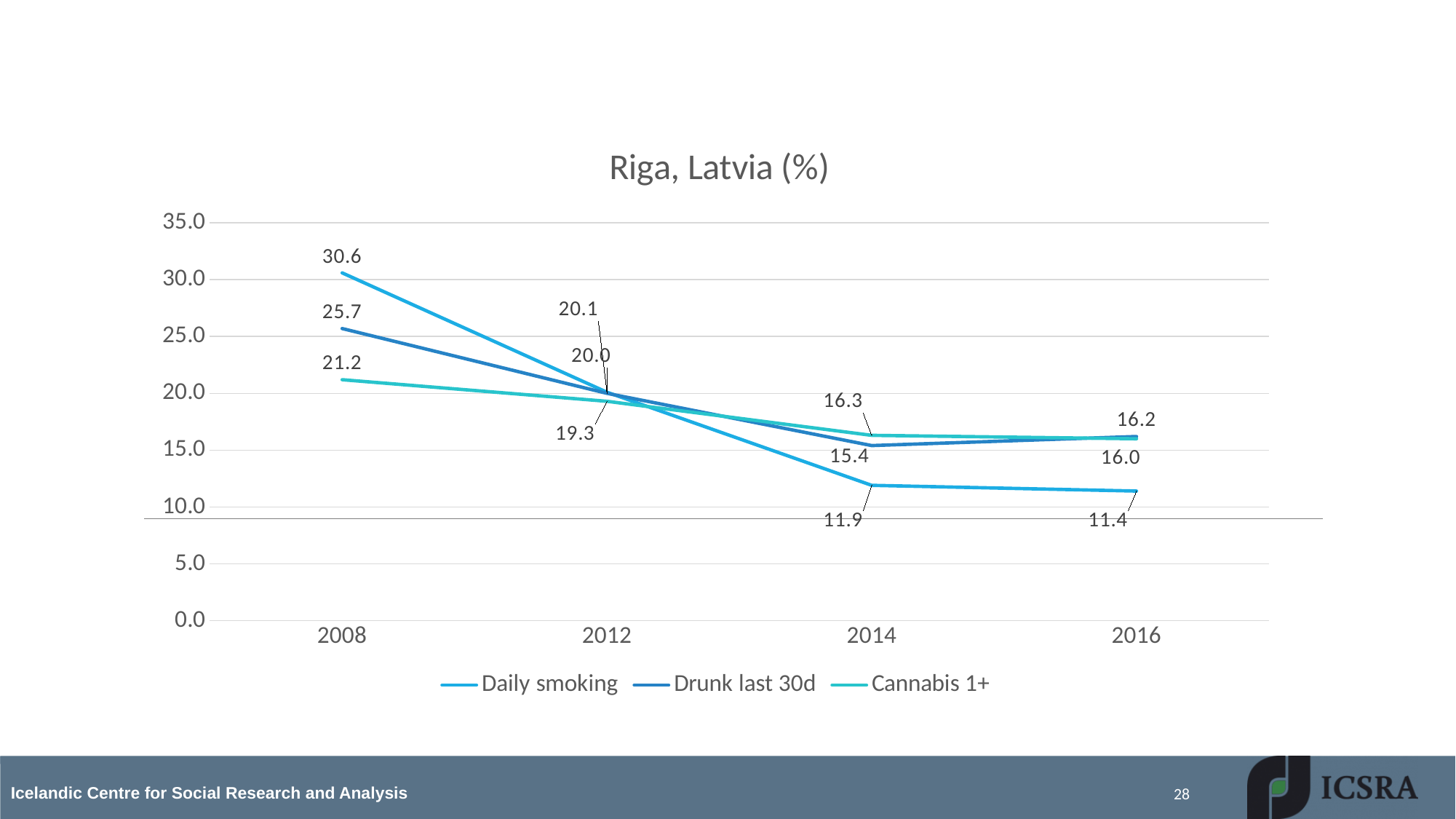
How many series does the legend list? 3 Does the Daily smoking line rise or fall from 2008 to 2016? Falls How many years are shown on the x axis? 4 Which series has the highest value in 2008? Daily smoking Which series has the lowest value in 2016? Daily smoking By how much did Daily smoking fall from 2008 to 2016? 19.2 What is the value for Drunk last 30d in 2014? 15.4 What is the value for Cannabis 1+ in 2012? 19.3 In 2014, which is larger: Cannabis 1+ or Drunk last 30d? Cannabis 1+ What is the value for Cannabis 1+ in 2016? 16.0 What kind of chart is shown on the slide? Line chart What is the value for Daily smoking in 2008? 30.6